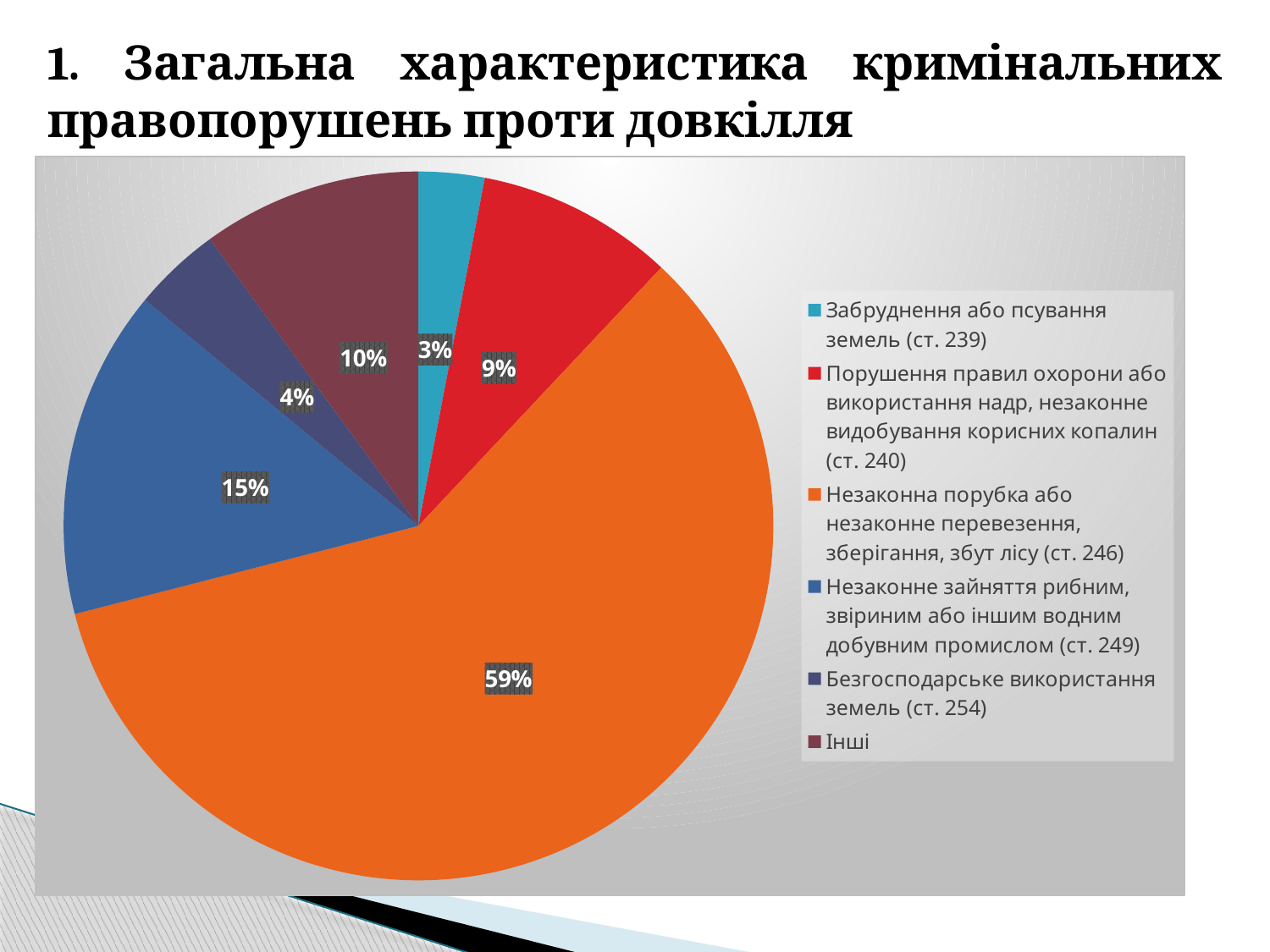
Which is larger: the slice for ст. 240 or the slice for "Інші"? Інші What percentage is shown for "Незаконне зайняття рибним, звіриним або іншим водним добувним промислом (ст. 249)"? 15% What percentage is shown for the "Інші" slice? 10% What kind of chart is shown on the slide? pie chart What is the difference in percentage points between the slice for ст. 246 and the slice for ст. 249? 44 What percentage is shown for "Забруднення або псування земель (ст. 239)"? 3% What colour is the slice for "Порушення правил охорони або використання надр, незаконне видобування корисних копалин (ст. 240)"? red What share of the pie is labelled for "Незаконна порубка або незаконне перевезення, зберігання, збут лісу (ст. 246)"? 59% What percentage is shown for "Безгосподарське використання земель (ст. 254)"? 4% Which category has the largest slice of the pie? Незаконна порубка або незаконне перевезення, зберігання, збут лісу (ст. 246) Which category has the smallest slice of the pie? Забруднення або псування земель (ст. 239) How many slices does the pie chart have? 6